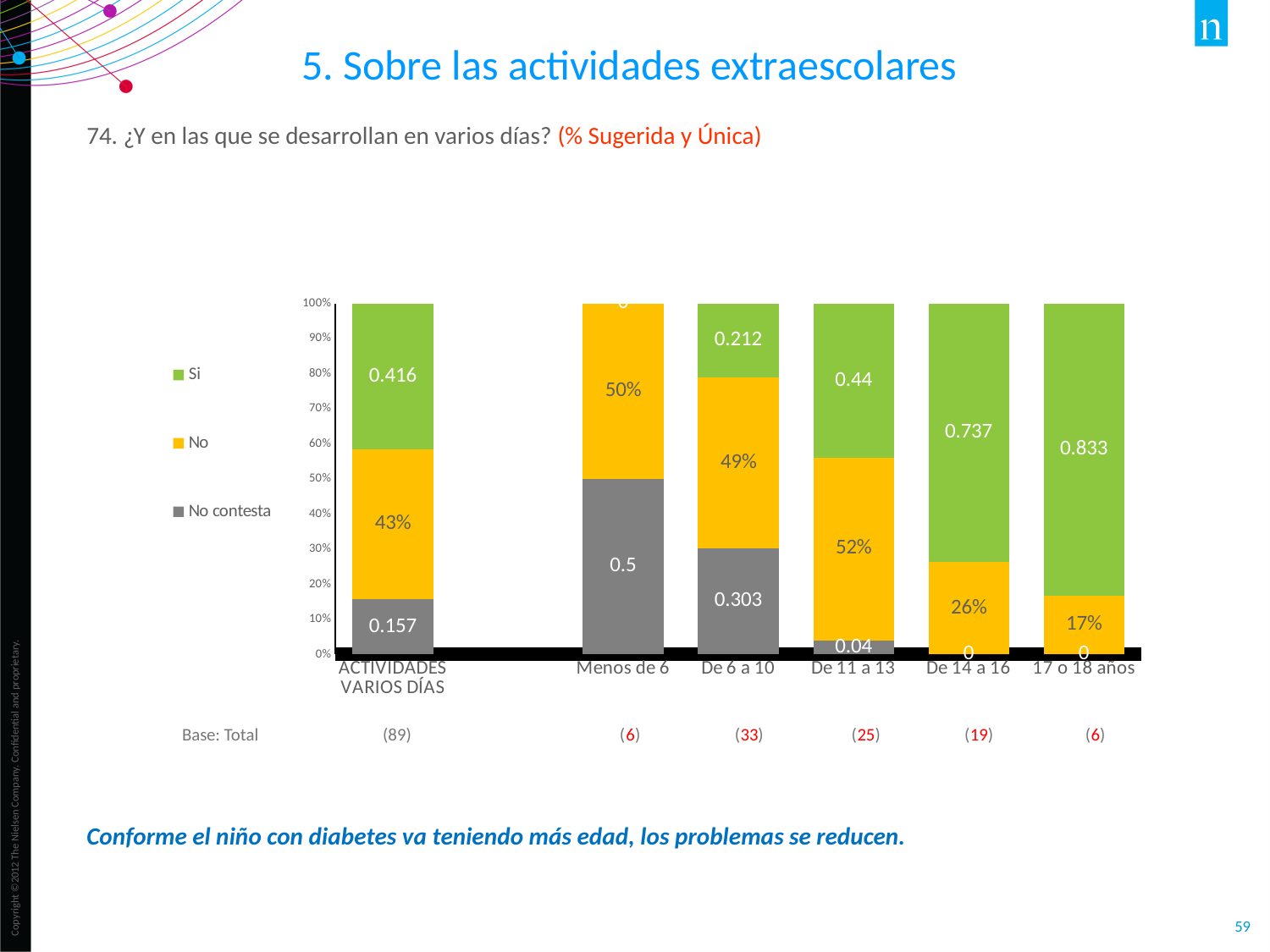
What is the difference between the 'Si' values for '17 o 18 años' and 'De 14 a 16'? 0.096 Does the 'Si' value rise or fall from 'De 6 a 10' to '17 o 18 años'? Rise What kind of chart is shown on the slide? Stacked bar chart Which is larger: the 'No contesta' value for 'Menos de 6' or for 'De 6 a 10'? Menos de 6 What is the value of the 'Si' series for the '17 o 18 años' category? 0.833 Which category has the highest value for the 'Si' series? 17 o 18 años What is the value of the 'No contesta' series for the 'De 6 a 10' category? 0.303 What is the value of the 'No' series for the 'De 11 a 13' category? 52% How many categories are shown on the x axis of the chart? 6 What is the value of the 'Si' series for the 'ACTIVIDADES VARIOS DÍAS' category? 0.416 Which category has the lowest value for the 'No' series? 17 o 18 años How many series does the chart legend list? 3